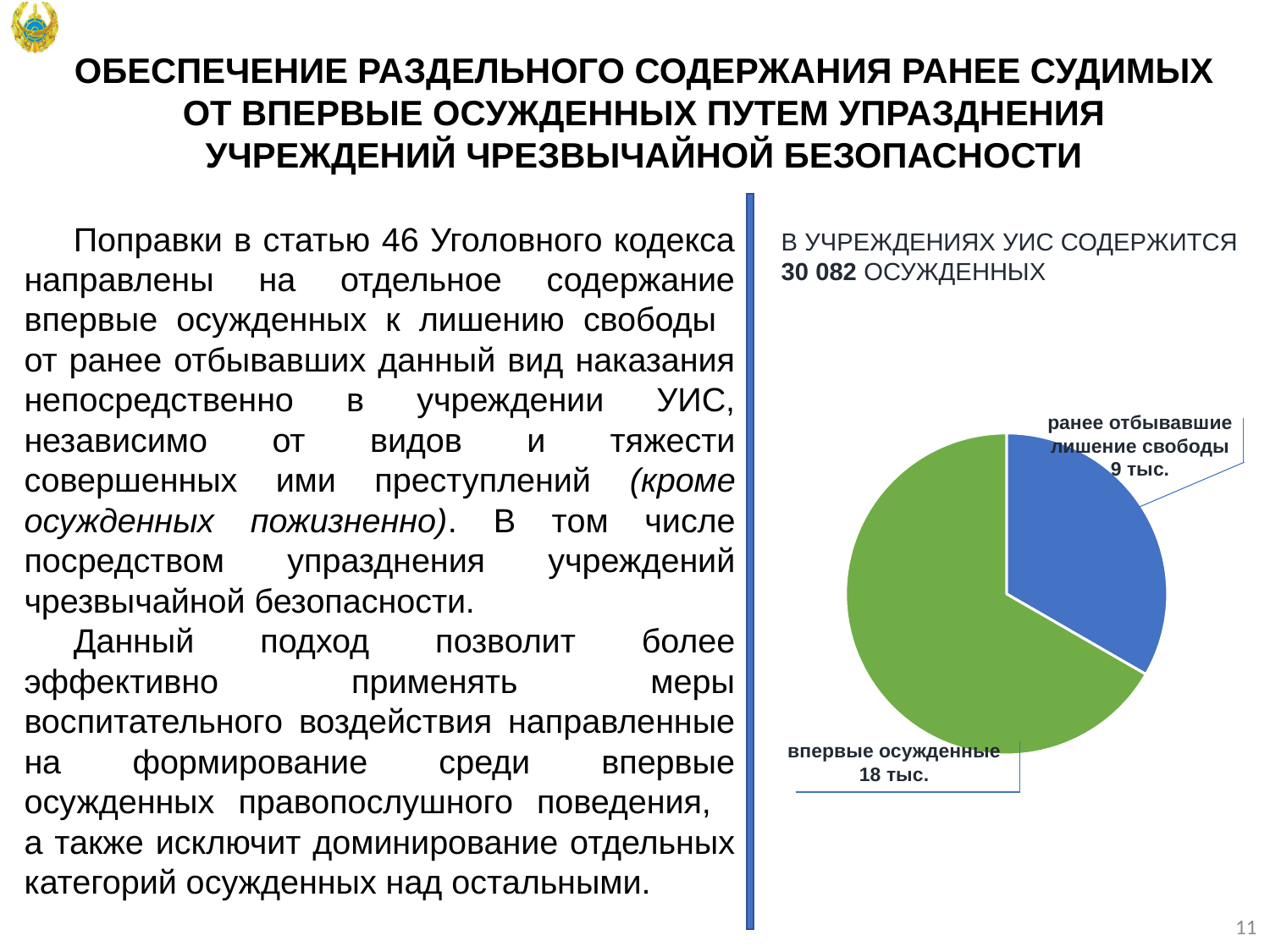
What value is shown for the slice 'ранее отбывавшие лишение свободы' in the pie chart? 9 тыс. Which category has the smallest slice in the pie chart? ранее отбывавшие лишение свободы What value is shown for the slice 'впервые осужденные' in the pie chart? 18 тыс. Which category has the largest slice in the pie chart? впервые осужденные What colour is the slice for 'ранее отбывавшие лишение свободы' in the pie chart? blue What type of chart is shown on the slide? pie chart By how much does the value for 'впервые осужденные' exceed the value for 'ранее отбывавшие лишение свободы' in the pie chart? 9 тыс. Which is larger in the pie chart: 'впервые осужденные' or 'ранее отбывавшие лишение свободы'? впервые осужденные How many slices does the pie chart have? 2 What colour is the slice for 'впервые осужденные' in the pie chart? green